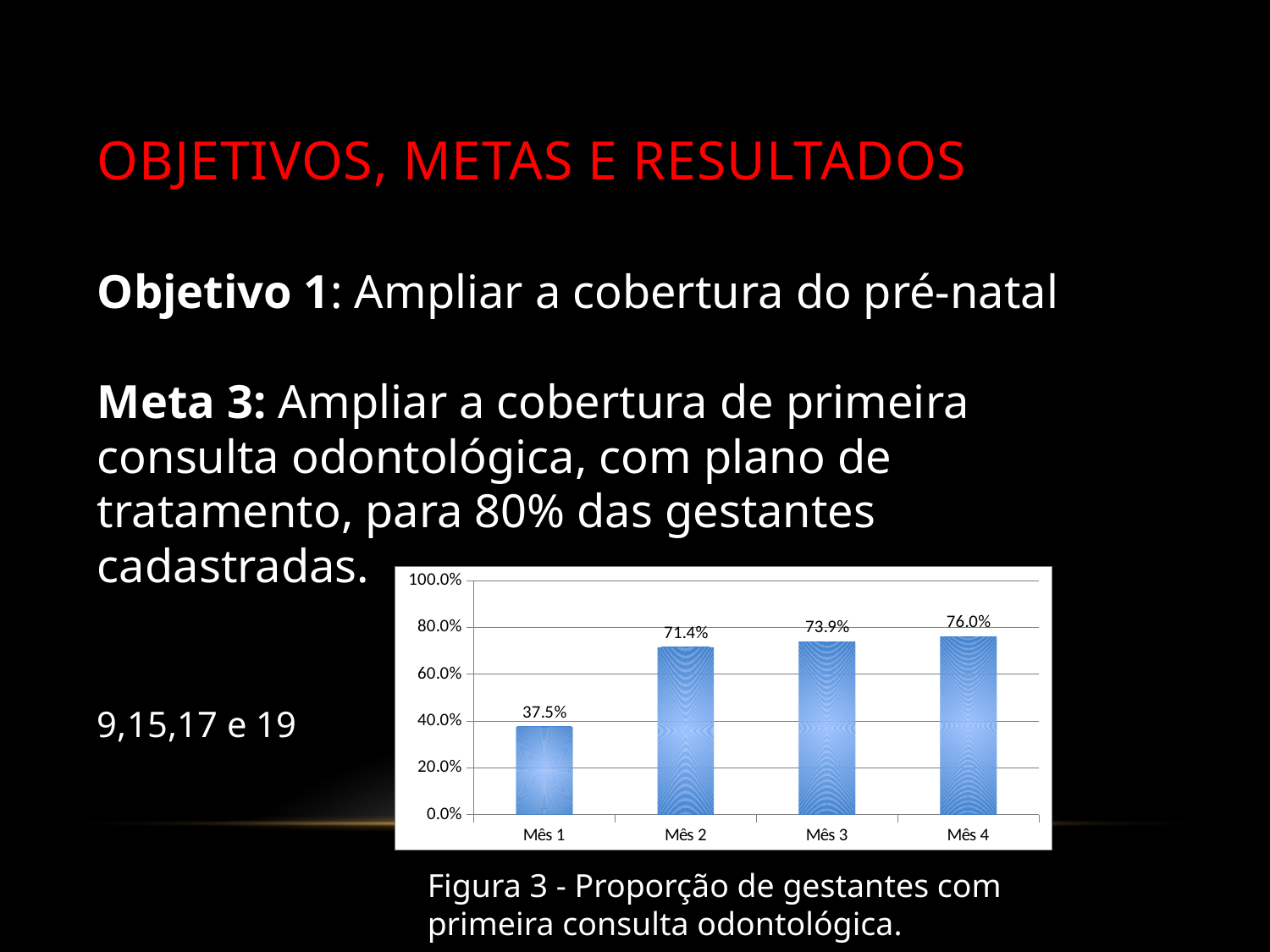
What is the value for Mês 4? 76.0% Which month has the highest value? Mês 4 What is the value for Mês 2? 71.4% Which month has the lowest value? Mês 1 Which is larger, the value for Mês 2 or the value for Mês 1? Mês 2 What is the value for Mês 1? 37.5% Do the values rise or fall from Mês 1 to Mês 4? Rise How many months are shown on the x axis? 4 What is the difference between the values for Mês 2 and Mês 1? 33.9% What kind of chart is shown? Bar chart What is the value for Mês 3? 73.9% What is the difference between the values for Mês 4 and Mês 1? 38.5%